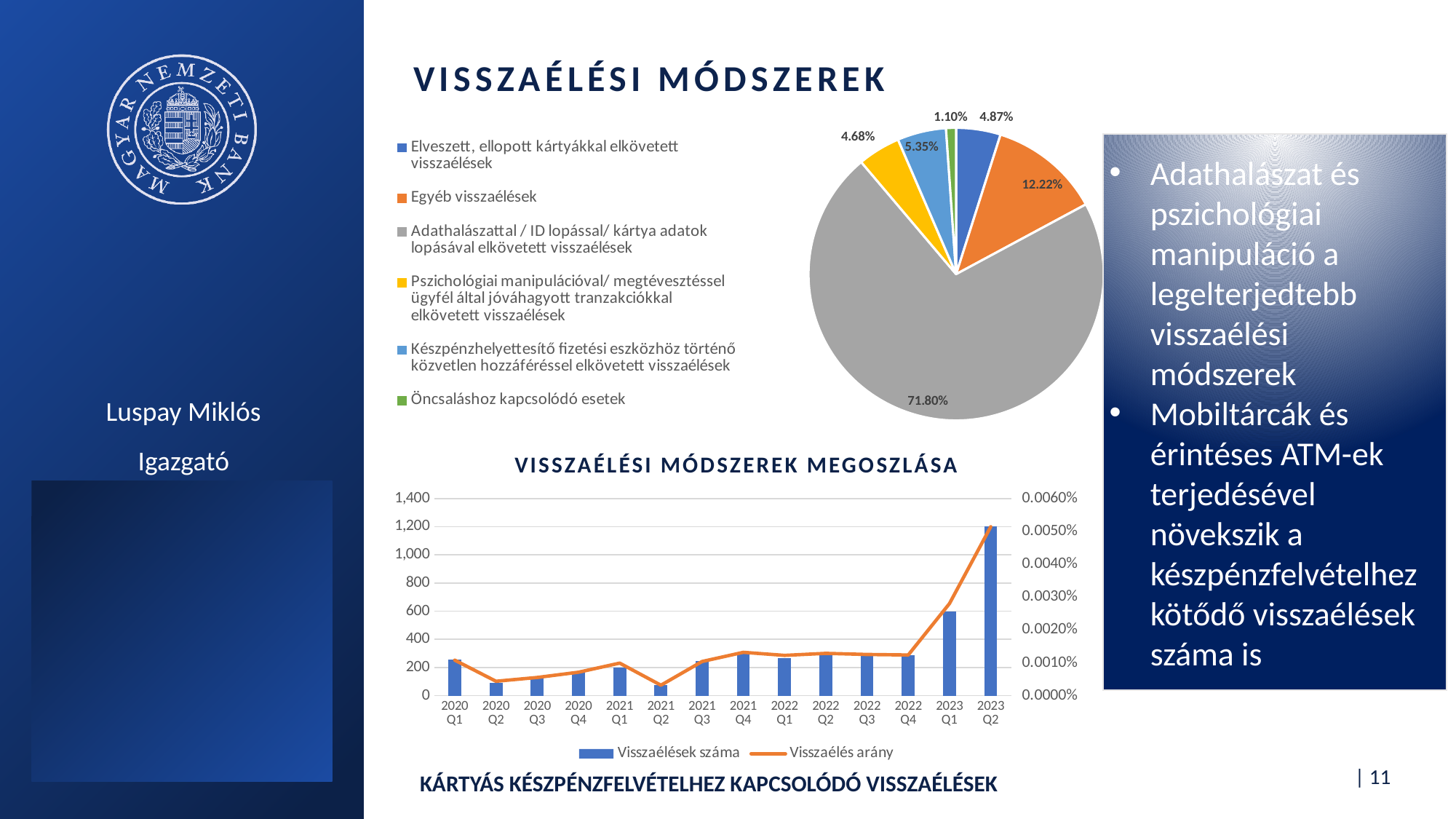
In the chart titled 'Visszaélési módszerek megoszlása', is the 'Visszaélések száma' bar for 2023 Q2 greater or less than 1,000? greater In the chart titled 'Visszaélési módszerek megoszlása', how many quarters are shown on the x axis? 14 In the pie chart at the top, what share is shown for 'Adathalászattal / ID lopással/ kártya adatok lopásával elkövetett visszaélések'? 71.80% In the pie chart at the top, what share is shown for 'Öncsaláshoz kapcsolódó esetek'? 1.10% In the chart titled 'Visszaélési módszerek megoszlása', which quarter has the highest bar for 'Visszaélések száma'? 2023 Q2 In the pie chart at the top, what is the difference between the shares for 'Egyéb visszaélések' and 'Elveszett, ellopott kártyákkal elkövetett visszaélések'? 7.35% In the chart titled 'Visszaélési módszerek megoszlása', which is larger, the 'Visszaélések száma' bar for 2023 Q1 or for 2022 Q4? 2023 Q1 In the chart titled 'Visszaélési módszerek megoszlása', how many series does the legend list? 2 In the pie chart at the top, which category has the largest slice? Adathalászattal / ID lopással/ kártya adatok lopásával elkövetett visszaélések In the pie chart at the top, how many categories does the legend list? 6 In the pie chart at the top, which category has the smallest slice? Öncsaláshoz kapcsolódó esetek In the pie chart at the top, what share is shown for 'Egyéb visszaélések'? 12.22%